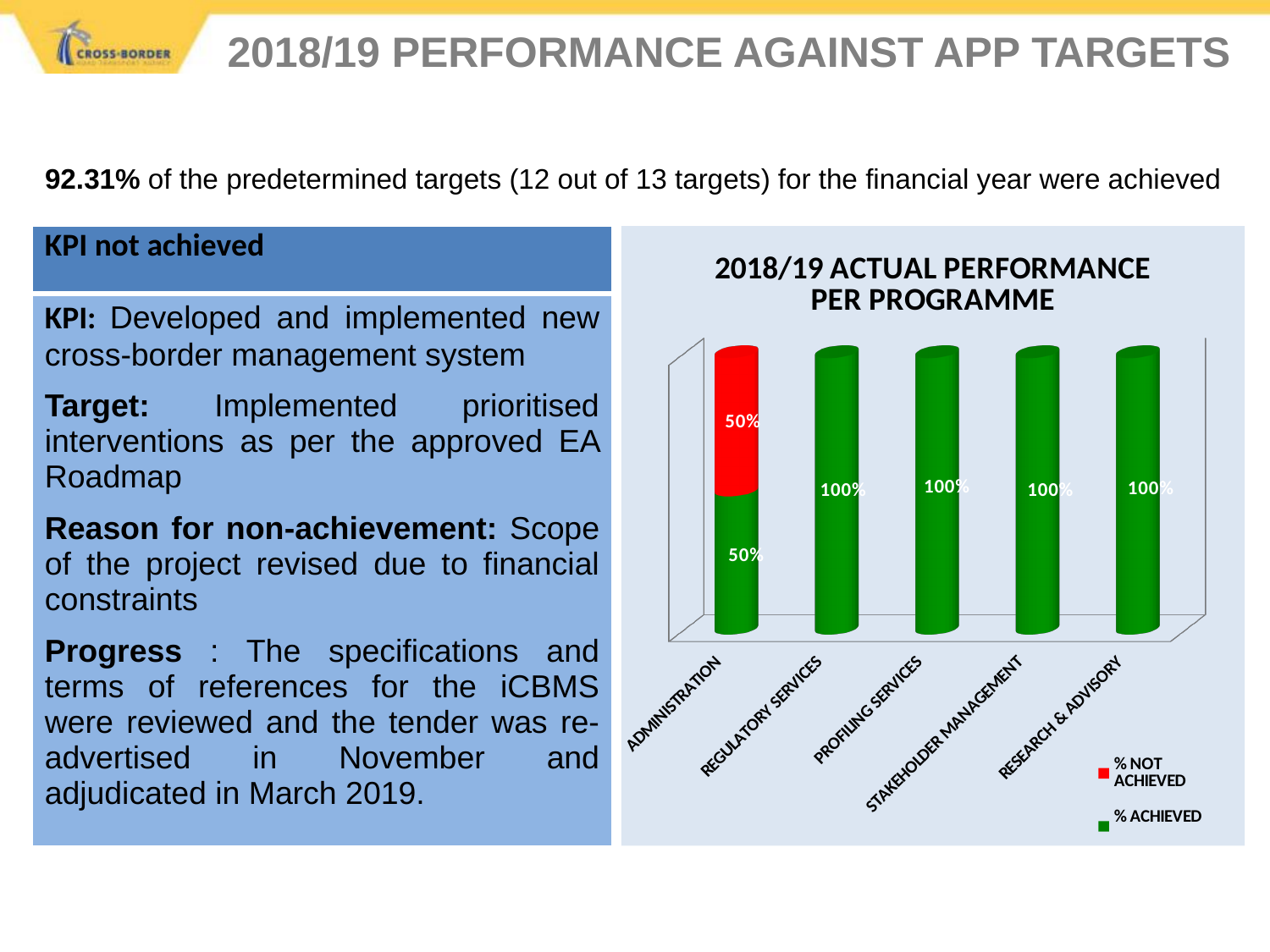
Which is larger, the % ACHIEVED value for PROFILING SERVICES or for ADMINISTRATION? PROFILING SERVICES What is the % ACHIEVED value for ADMINISTRATION? 50% Which colour represents % NOT ACHIEVED in the chart's legend? red How many series does the chart's legend list? 2 What is the % ACHIEVED value for STAKEHOLDER MANAGEMENT? 100% How many programmes (categories) are shown on the x axis of the chart? 5 What is the title of the chart? 2018/19 ACTUAL PERFORMANCE PER PROGRAMME Which programme has the lowest % ACHIEVED value? ADMINISTRATION What is the difference between the % ACHIEVED value for RESEARCH & ADVISORY and for ADMINISTRATION? 50% What is the % ACHIEVED value for REGULATORY SERVICES? 100% What kind of chart is shown on the slide? bar chart What is the % NOT ACHIEVED value for ADMINISTRATION? 50%